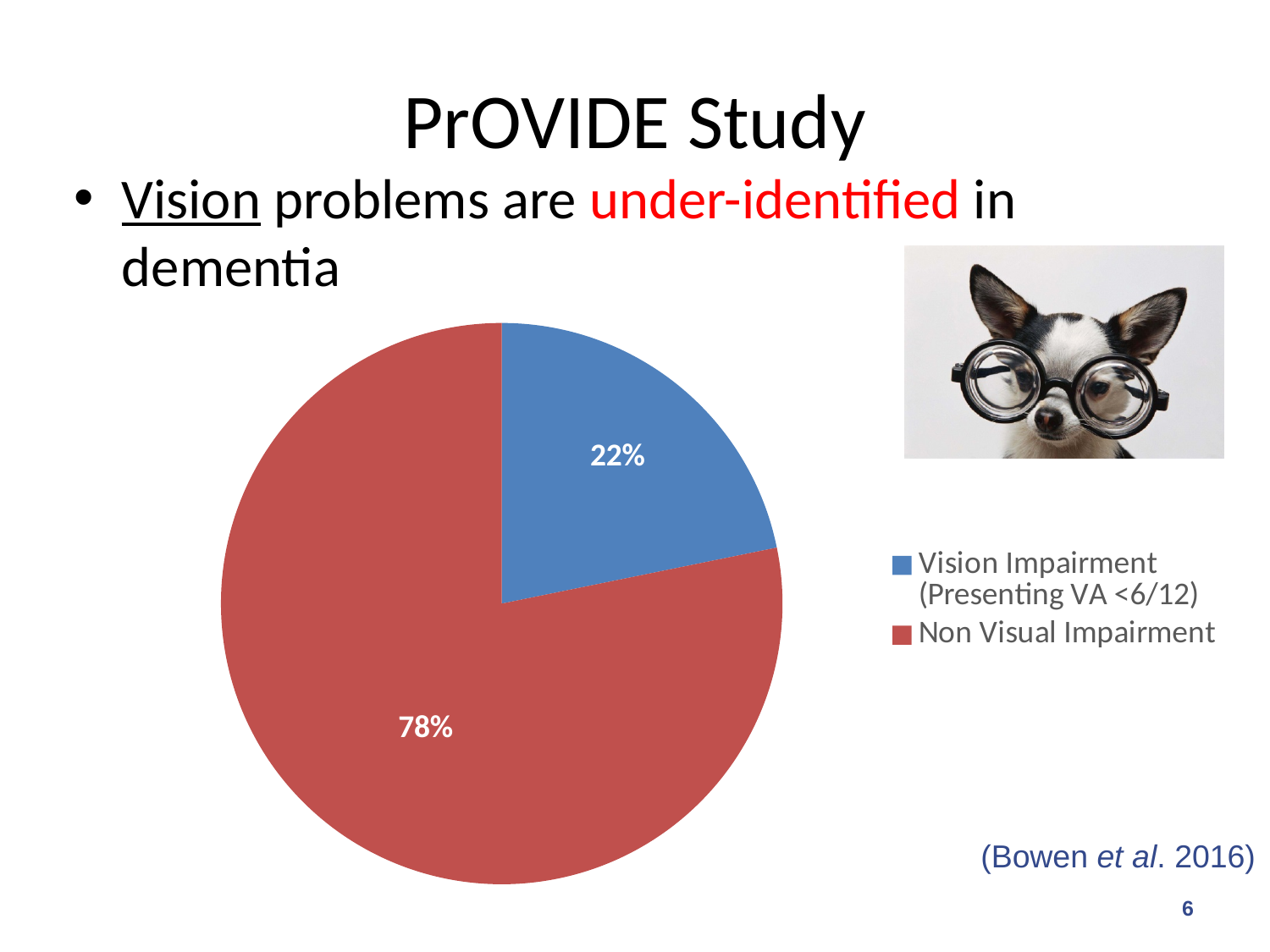
Which slice of the pie is the largest? Non Visual Impairment What share of the pie does the Vision Impairment (Presenting VA <6/12) slice represent? 22% What percentage of the pie is labelled for Vision Impairment (Presenting VA <6/12)? 22% How many slices does the pie chart have? 2 What kind of chart is shown on the slide? pie chart What is the difference in percentage points between the Non Visual Impairment slice and the Vision Impairment slice? 56 What percentage of the pie is labelled for Non Visual Impairment? 78% Which slice of the pie is the smallest? Vision Impairment (Presenting VA <6/12) What colour is the Non Visual Impairment slice? red Which is larger: the Vision Impairment slice or the Non Visual Impairment slice? Non Visual Impairment How many entries does the legend list? 2 What colour is the Vision Impairment (Presenting VA <6/12) slice? blue